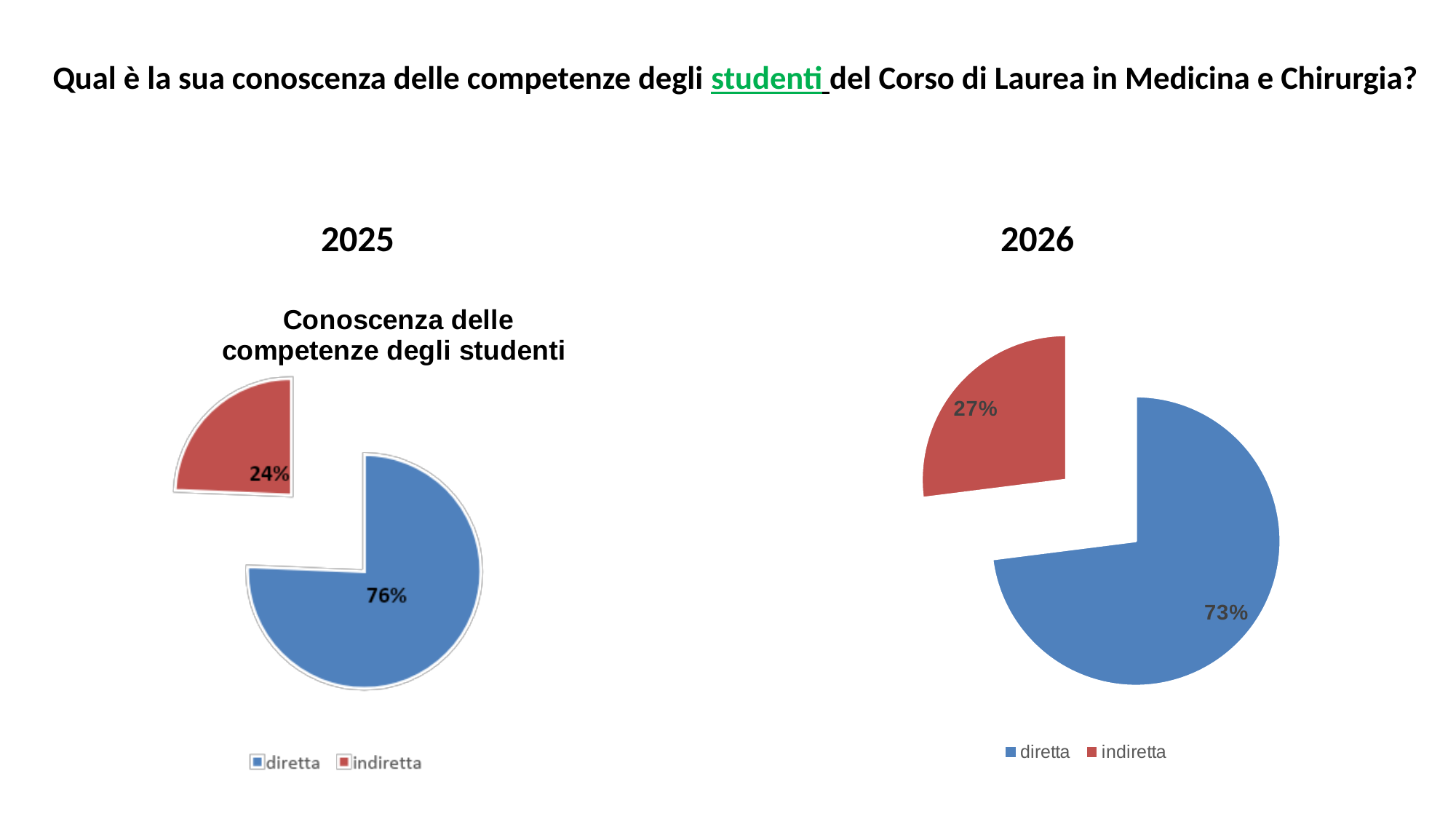
What is the title of the 2025 pie chart? Conoscenza delle competenze degli studenti In the 2025 pie chart, what is the share for 'diretta'? 76% In the 2025 pie chart, what is the share for 'indiretta'? 24% In the 2026 pie chart, what is the difference between the 'diretta' and 'indiretta' shares? 46% Is the 'diretta' share larger in the 2025 chart or in the 2026 chart? 2025 In the 2026 pie chart, what is the share for 'diretta'? 73% What kind of chart is used for the 2026 data? Pie chart In the 2025 pie chart, which category has the largest slice? diretta In the 2026 pie chart, what is the share for 'indiretta'? 27% In the 2025 pie chart, what is the difference between the 'diretta' and 'indiretta' shares? 52% In the 2026 pie chart, which category has the smallest slice? indiretta How many categories does the legend of the 2025 pie chart list? 2